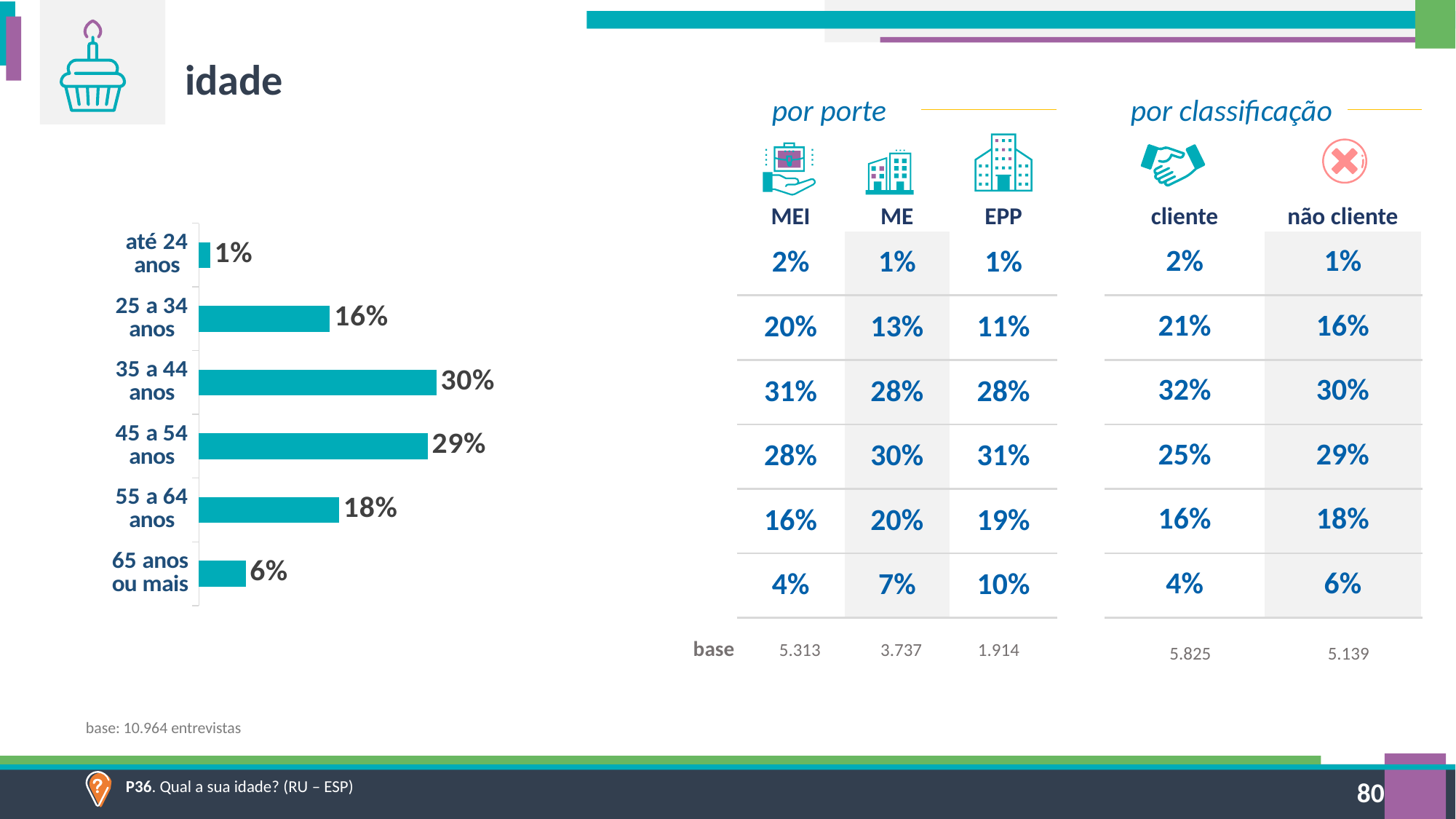
What is the difference between the values for '45 a 54 anos' and '65 anos ou mais' in the bar chart? 23 percentage points What is the value for the '35 a 44 anos' category in the bar chart? 30% Which age category has the lowest value in the bar chart? até 24 anos How many age categories are shown in the bar chart? 6 What is the title of the slide containing the bar chart? idade What is the difference between the values for '35 a 44 anos' and '25 a 34 anos' in the bar chart? 14 percentage points Which is larger in the bar chart: the value for '25 a 34 anos' or for '55 a 64 anos'? 55 a 64 anos What is the value for the '55 a 64 anos' category in the bar chart? 18% What kind of chart is used to show the age distribution on the slide? Bar chart Which age category has the highest value in the bar chart? 35 a 44 anos What is the value for the '65 anos ou mais' category in the bar chart? 6% What is the value for the '25 a 34 anos' category in the bar chart? 16%